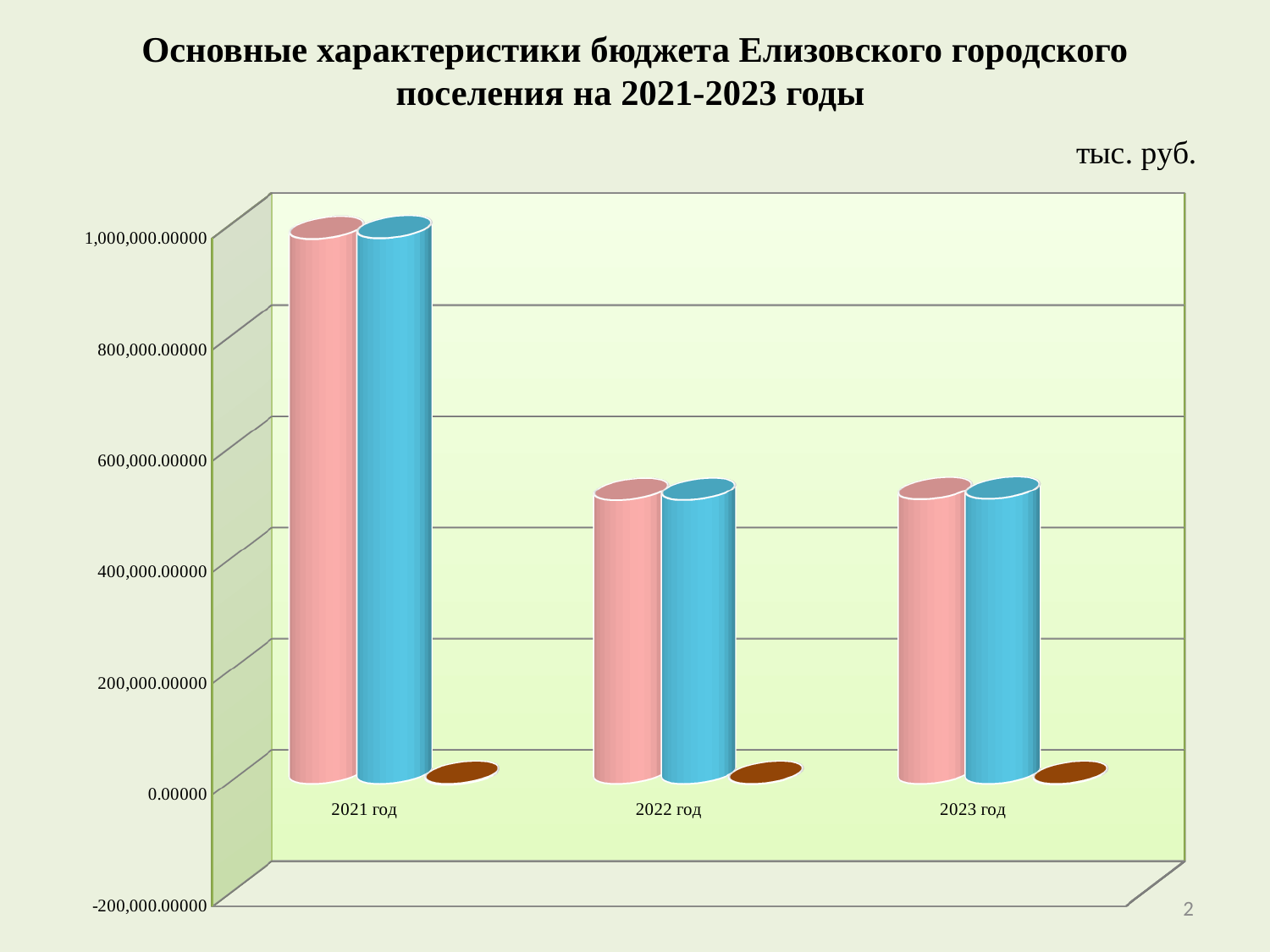
Is the value of the brown bar for 2021 год greater or less than 200,000.00000? less Is the value of the pink bar for 2021 год greater or less than 800,000.00000? greater Which year has the highest pink bar in the chart? 2021 год What is the title of the slide containing the chart? Основные характеристики бюджета Елизовского городского поселения на 2021-2023 годы Do the values of the pink bars rise or fall from 2021 год to 2022 год? fall How many year categories are shown on the x axis of the chart? 3 Which is larger: the blue bar for 2021 год or the blue bar for 2022 год? 2021 год What unit of measurement is indicated above the chart? тыс. руб. Is the value of the pink bar for 2023 год greater or less than 400,000.00000? greater What kind of chart is shown on the slide? bar chart How many bars are plotted for each year category in the chart? 3